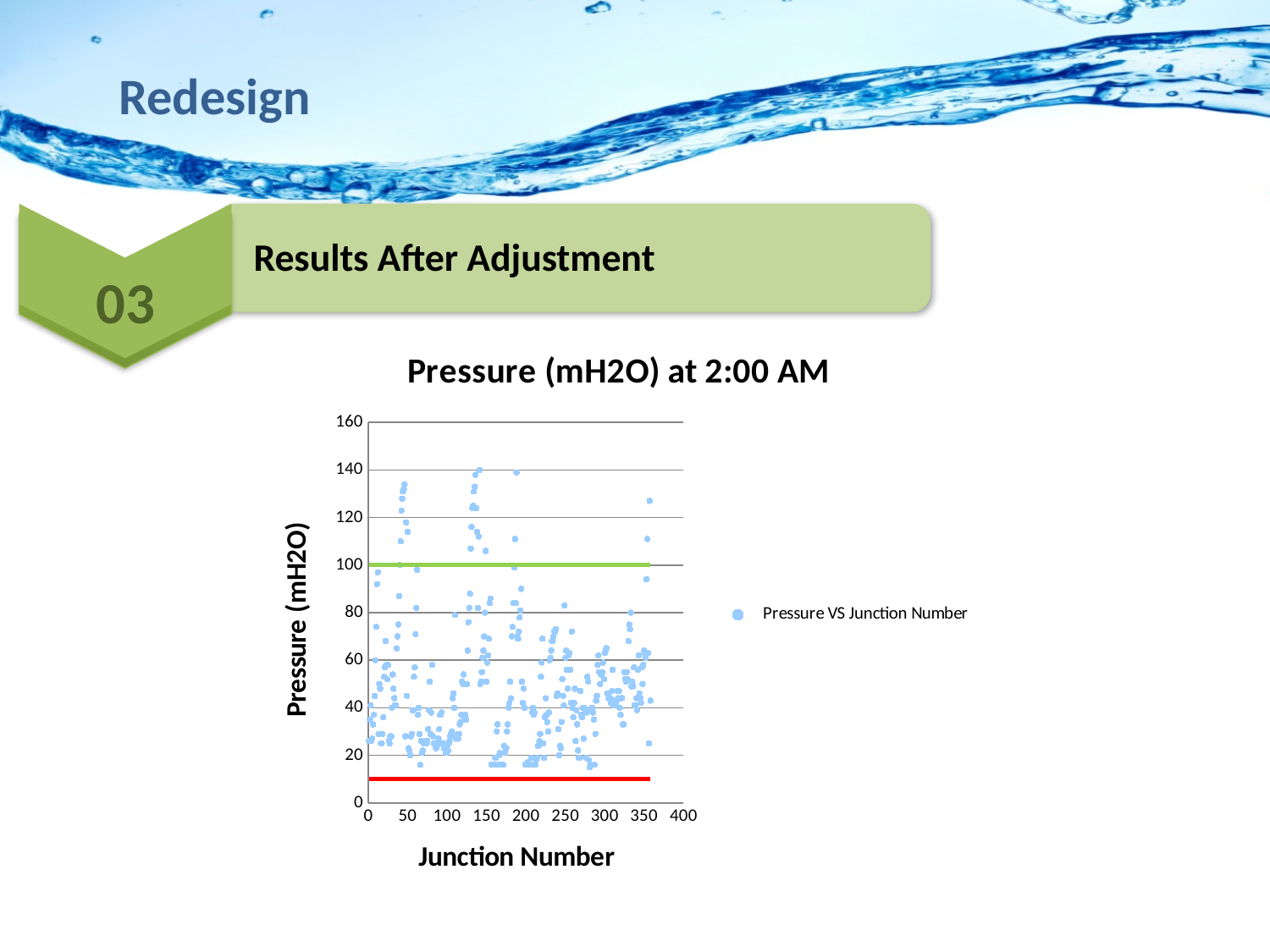
What is the title of the chart? Pressure (mH2O) at 2:00 AM What is the name of the series shown in the chart legend? Pressure VS Junction Number Is the lowest plotted pressure value greater or less than 20? less How many series does the chart legend list? 1 Are all plotted pressure values greater or less than 160? less Is the highest plotted pressure value greater or less than 120? greater What kind of chart is shown on the slide? scatter chart